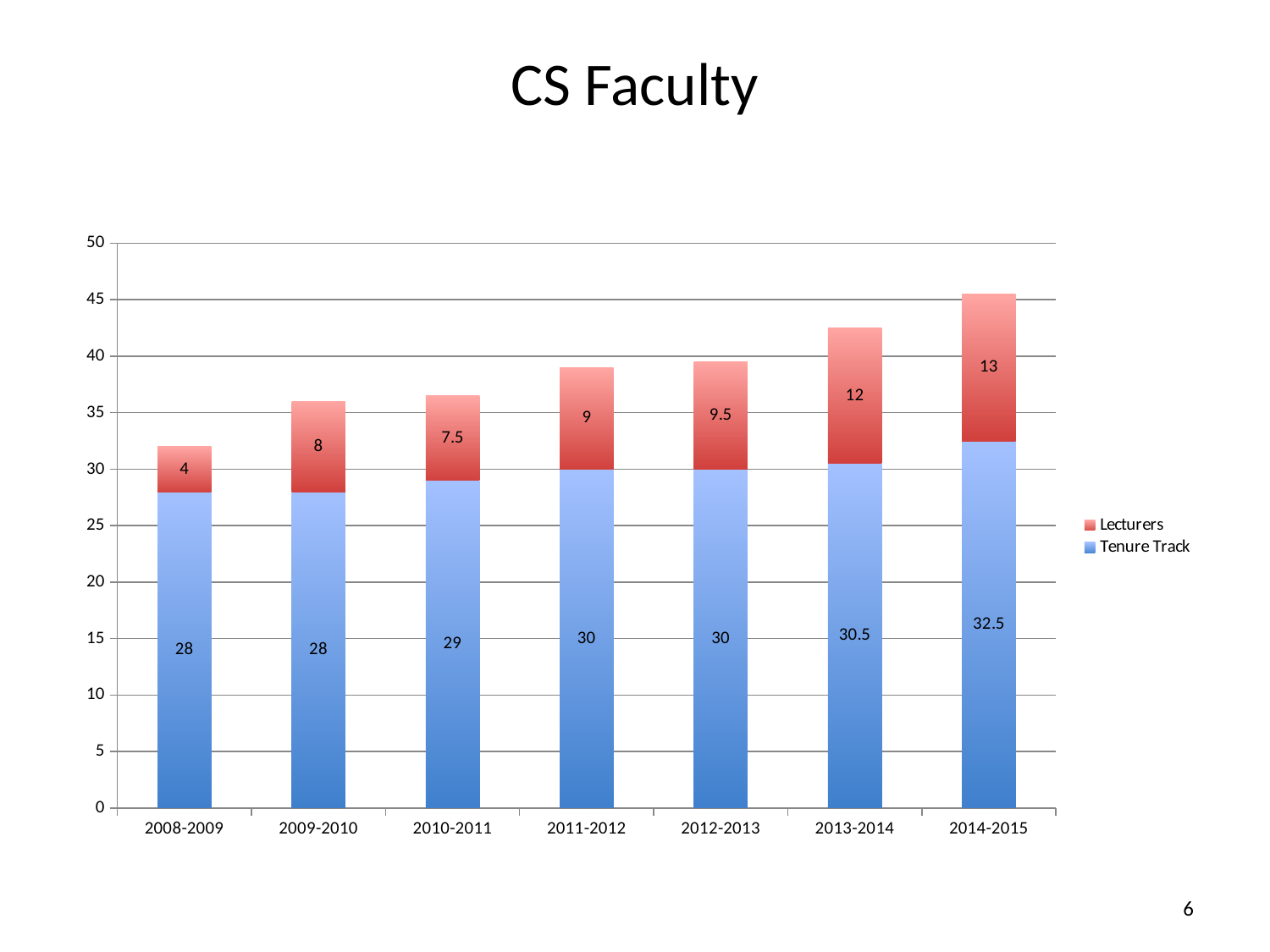
Which year has the lowest Lecturers value? 2008-2009 What is the Tenure Track value for 2010-2011? 29 What is the Lecturers value for 2012-2013? 9.5 What is the difference between the Lecturers values for 2014-2015 and 2013-2014? 1 Which is larger, the Lecturers value for 2011-2012 or for 2010-2011? 2011-2012 Do the Lecturers values rise or fall from 2008-2009 to 2014-2015? Rise What kind of chart is shown on the slide? Stacked bar chart Which year has the highest Tenure Track value? 2014-2015 How many series does the legend list? 2 What is the total of the stacked bar for 2013-2014? 42.5 How many years are shown on the x axis? 7 What is the Lecturers value for 2008-2009? 4